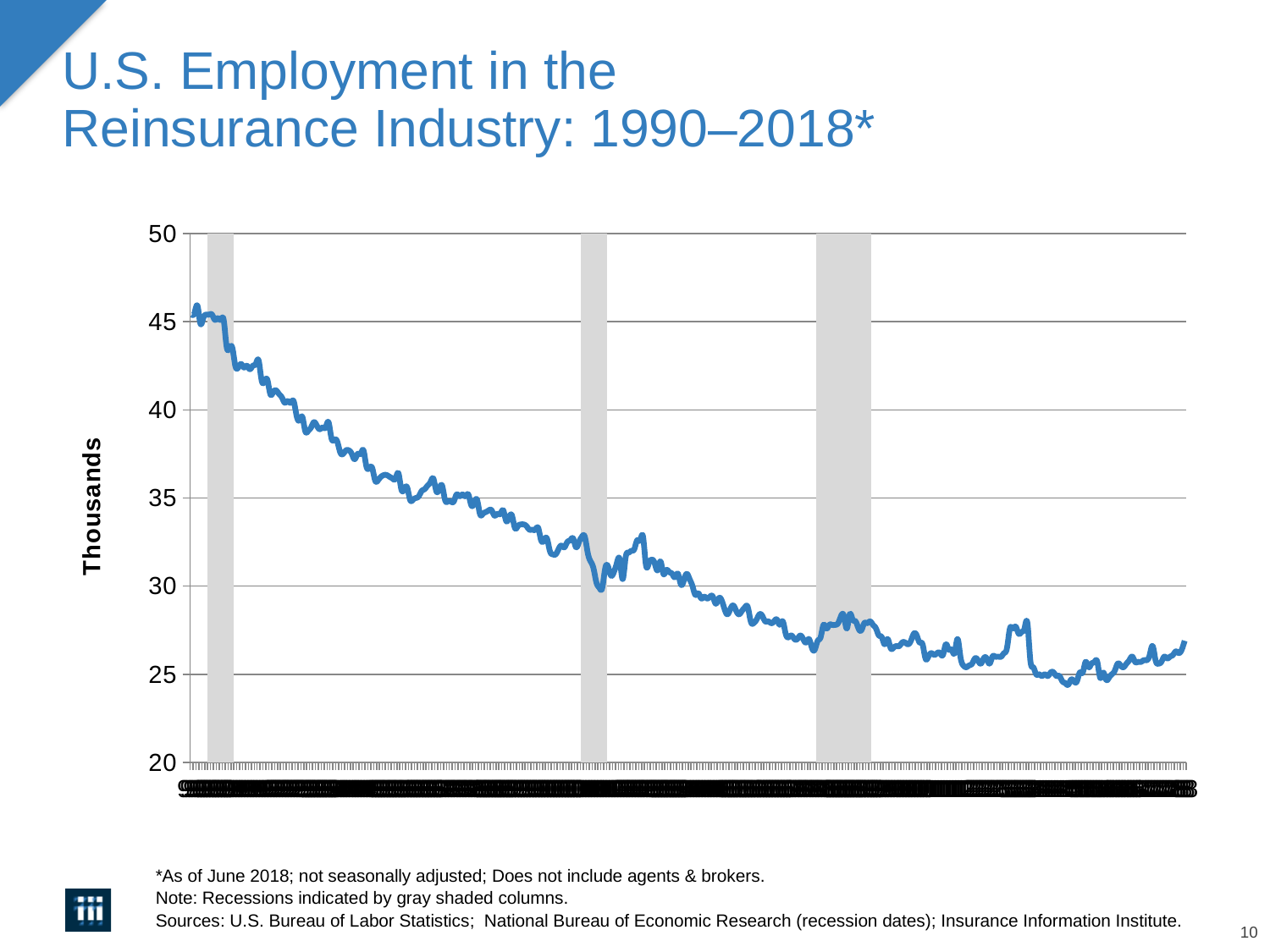
What kind of chart is shown on the slide? line chart What is the highest value shown on the vertical axis? 50 How many gray shaded recession columns are shown on the chart? 3 Is the lowest point of the line greater or less than 30? less What is the lowest value shown on the vertical axis? 20 Is the highest point of the line greater or less than 45? greater Do the values generally rise or fall from left to right across the chart? fall Is the value at the start of the series (left end of the line) greater or less than 40? greater What is the label on the vertical axis? Thousands